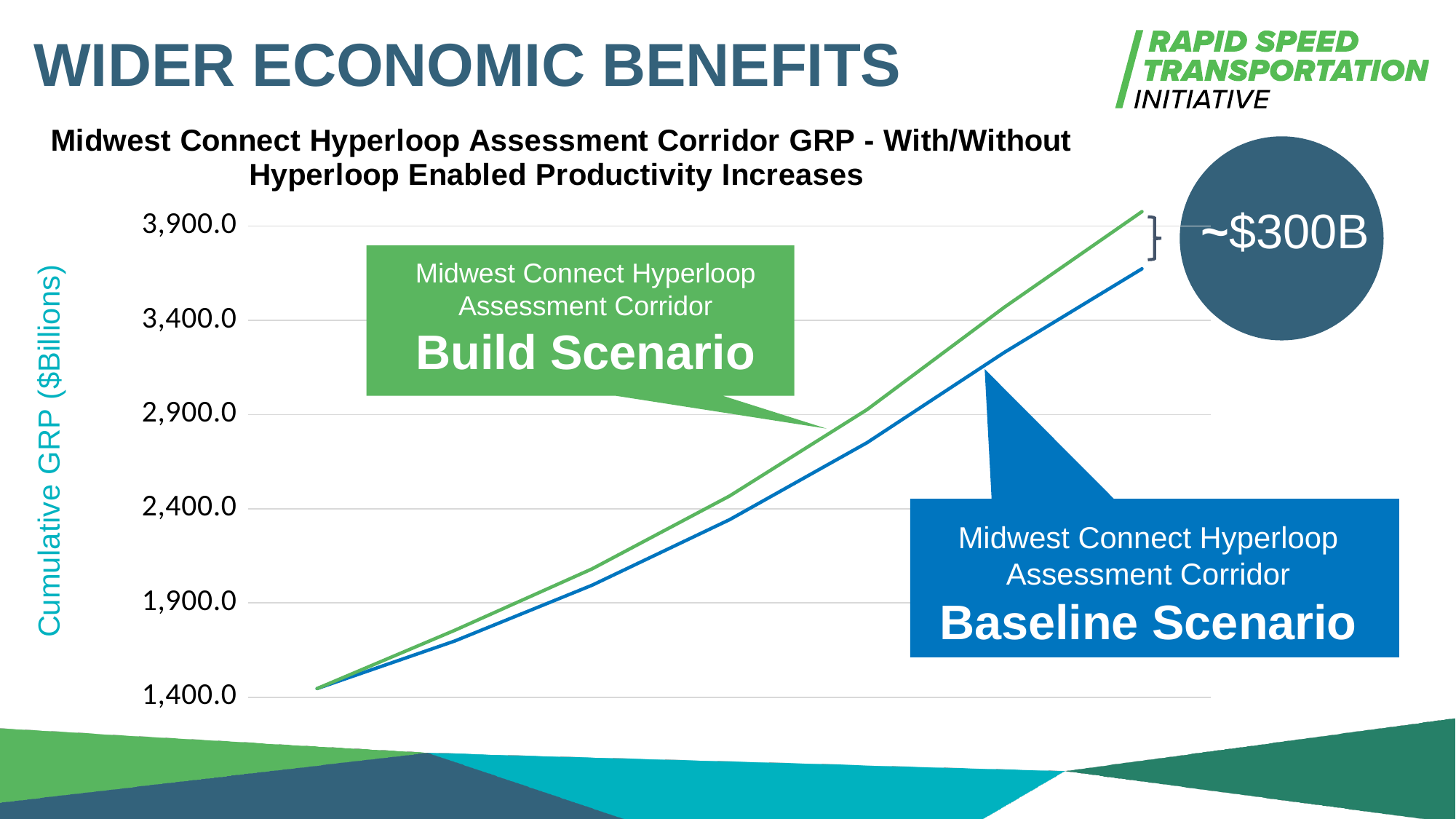
Is the final value of the Build Scenario line greater or less than 3,400.0? greater What is the label on the vertical axis of the chart? Cumulative GRP ($Billions) Is the starting value of the Build Scenario line greater or less than 1,900.0? less Do the values of the Build Scenario line rise or fall from left to right? rise Is the final value of the Baseline Scenario line greater or less than 3,400.0? greater What kind of chart is shown on the slide? line chart Do the values of the Baseline Scenario line rise or fall from left to right? rise At the right end of the chart, which line is higher: the Build Scenario or the Baseline Scenario? Build Scenario How many scenario lines are plotted on the chart? 2 What is the lowest value shown on the vertical axis of the chart? 1,400.0 What is the title of the chart? Midwest Connect Hyperloop Assessment Corridor GRP - With/Without Hyperloop Enabled Productivity Increases